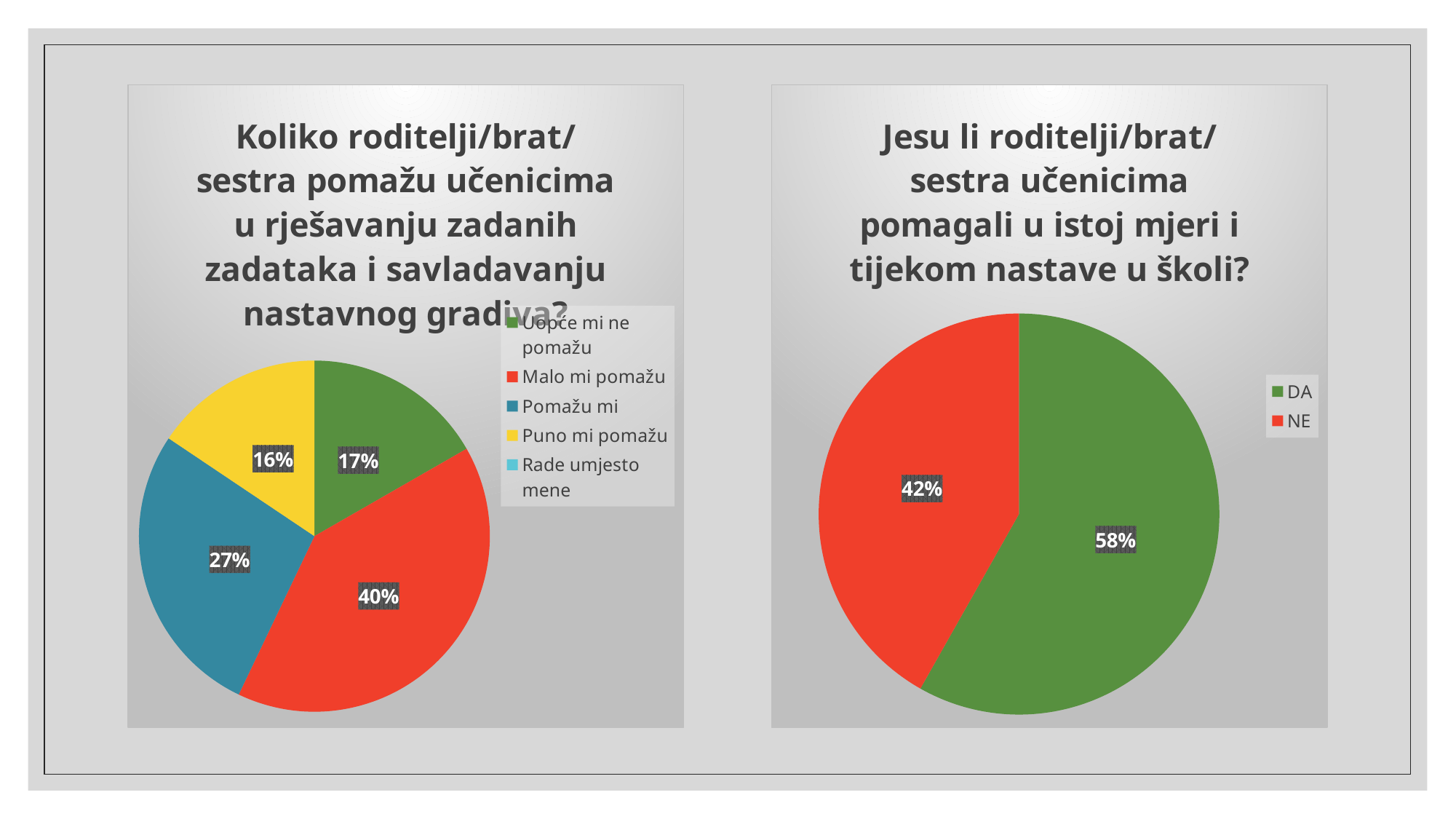
What type of chart is the right chart? Pie chart In the left chart, which category has the largest slice? Malo mi pomažu In the right chart, what percentage answered "DA"? 58% In the left chart, how many entries does the legend list? 5 In the left chart, what is the difference between the "Malo mi pomažu" and "Pomažu mi" slices? 13% In the right chart, what is the difference between the "DA" and "NE" slices? 16% In the left chart, what percentage is shown for "Pomažu mi"? 27% In the left chart, which is larger, "Pomažu mi" or "Puno mi pomažu"? Pomažu mi In the left chart, what percentage is shown for "Puno mi pomažu"? 16% In the left chart, what percentage is shown for "Uopće mi ne pomažu"? 17% In the left chart, what percentage is shown for "Malo mi pomažu"? 40% In the right chart, what percentage answered "NE"? 42%